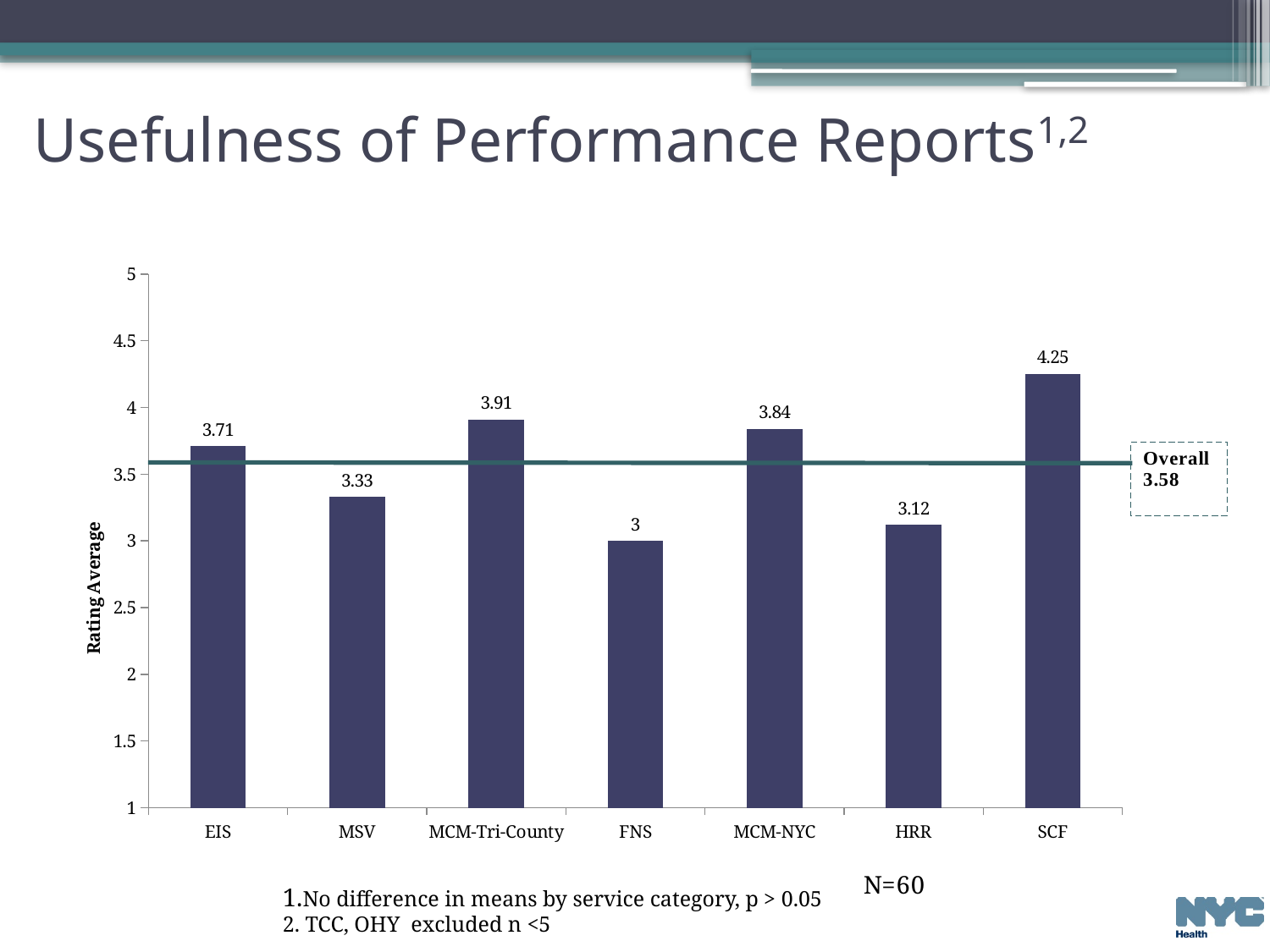
Is the rating average for HRR greater or less than 3.5? less What is the difference between the rating averages for SCF and EIS? 0.54 What is the label of the y axis? Rating Average Which service category has the lowest rating average? FNS What is the rating average for FNS? 3 What is the rating average for MCM-Tri-County? 3.91 What overall rating average is marked by the horizontal line? 3.58 What kind of chart is shown on the slide? bar chart Which service category has the highest rating average? SCF Which has a higher rating average, MSV or MCM-NYC? MCM-NYC What is the rating average for HRR? 3.12 How many service categories are shown on the x axis? 7